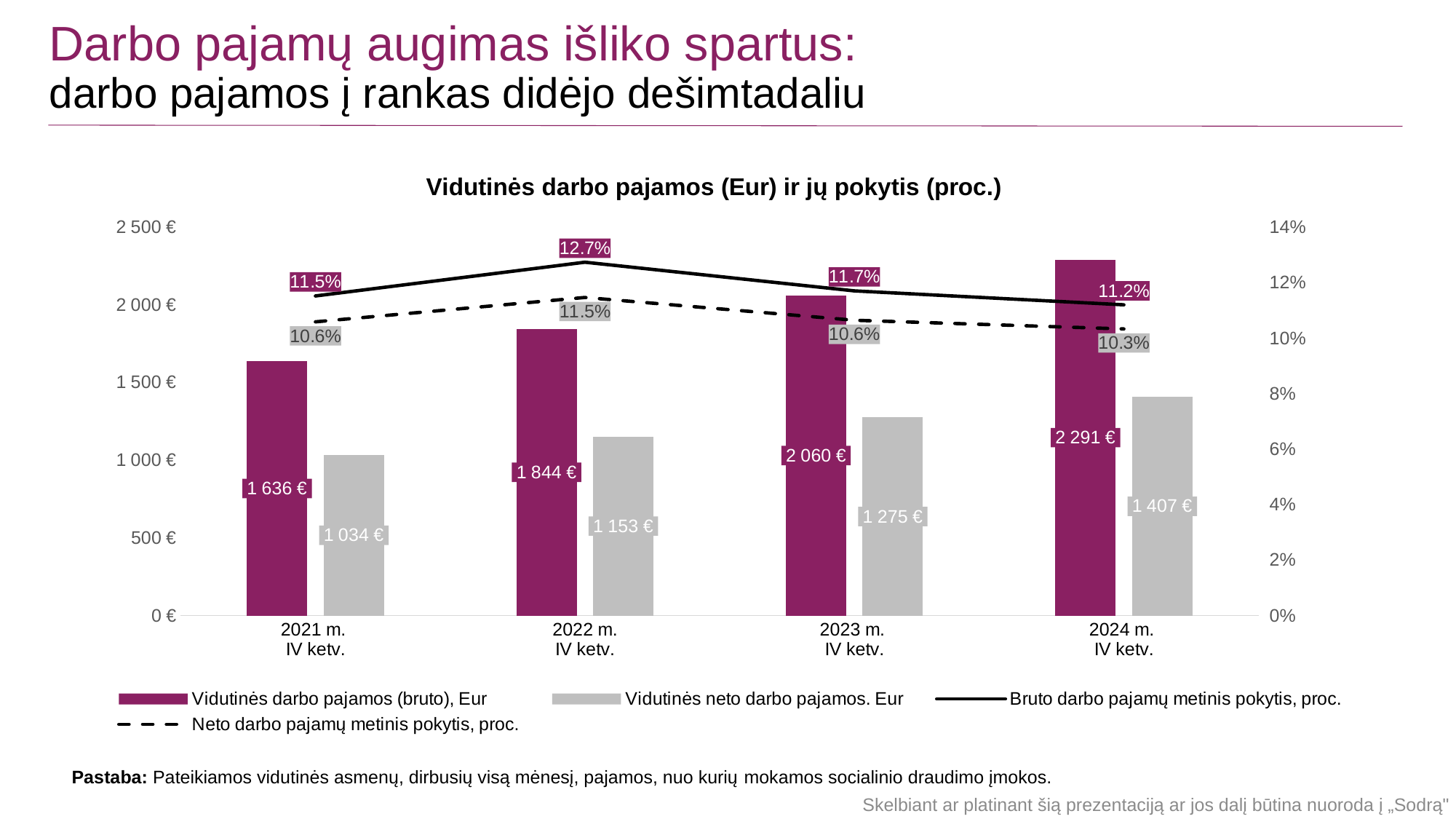
What is the difference between average gross and average net labour income in 2023 m. IV ketv.? 785 € What is the average gross labour income (Vidutinės darbo pajamos (bruto), Eur) for 2024 m. IV ketv.? 2 291 € What is the annual change in net labour income (Neto darbo pajamų metinis pokytis, proc.) for 2024 m. IV ketv.? 10.3% In which period is the average net labour income the lowest? 2021 m. IV ketv. Which is larger: the annual change in net labour income in 2022 m. IV ketv. or in 2023 m. IV ketv.? 2022 m. IV ketv. How many series does the legend list? 4 What kind of chart is used to show the average gross and net labour income? Bar chart In which period is the annual change in gross labour income the highest? 2022 m. IV ketv. What is the average net labour income (Vidutinės neto darbo pajamos, Eur) for 2021 m. IV ketv.? 1 034 € Do the average gross labour income bars rise or fall from 2021 m. IV ketv. to 2024 m. IV ketv.? Rise What is the annual change in gross labour income (Bruto darbo pajamų metinis pokytis, proc.) for 2022 m. IV ketv.? 12.7% How many periods are shown on the x axis? 4